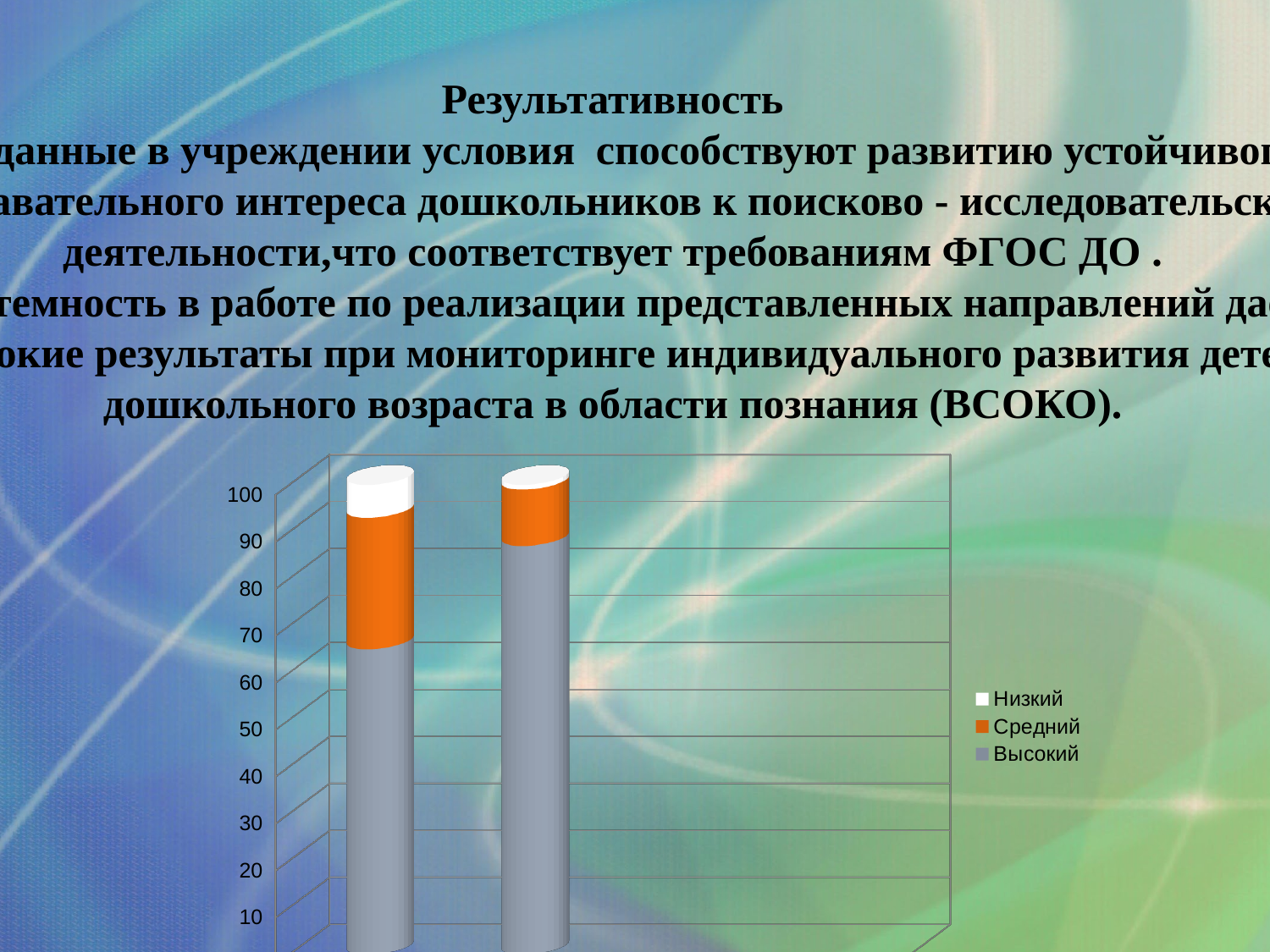
Does the Высокий segment rise or fall from the left bar to the right bar? rise Which legend entry is shown in orange? Средний How many bars are plotted in the chart? 2 Which bar has the larger Высокий segment, the left or the right? right Is the Высокий segment of the right bar greater or less than 80? greater Which legend entry is shown in white? Низкий Is the Высокий segment of the left bar greater or less than 70? less What kind of chart is shown on the slide? bar chart Which bar has the larger Средний segment, the left or the right? left How many series does the legend list? 3 Is the Высокий segment of the left bar greater or less than 60? greater